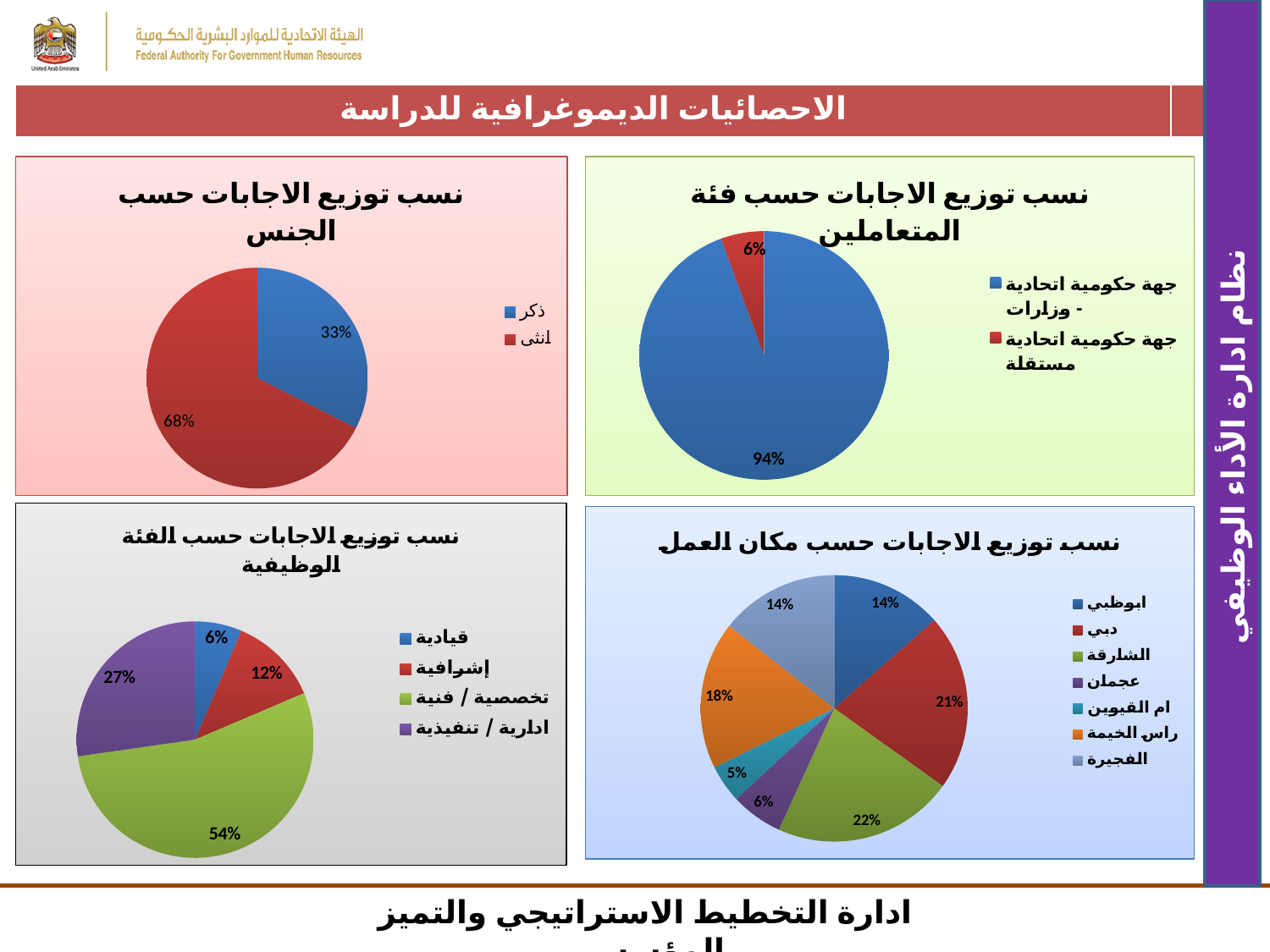
In the bottom-left pie chart (distribution of responses by job category), which category has the largest share? تخصصية / فنية In the bottom-left pie chart (distribution of responses by job category), which category has the smallest share? قيادية In the top-right pie chart (distribution of responses by customer category), how many slices does the pie have? 2 In the top-right pie chart (distribution of responses by customer category), what share is labelled for the federal government entities - ministries (جهة حكومية اتحادية - وزارات) slice? 94% In the bottom-right pie chart (distribution of responses by workplace), which is larger, the share for دبي or the share for ابوظبي? دبي In the bottom-right pie chart (distribution of responses by workplace), how many entries does the legend list? 7 In the top-left pie chart (distribution of responses by gender), what share is labelled for the male (ذكر) slice? 33% In the top-left pie chart (distribution of responses by gender), what share is labelled for the female (أنثى) slice? 68% What type of chart is used in the bottom-left panel (distribution of responses by job category)? Pie chart In the bottom-right pie chart (distribution of responses by workplace), what share is labelled for راس الخيمة? 18% In the bottom-right pie chart (distribution of responses by workplace), which emirate has the smallest share? ام القيوين In the bottom-left pie chart (distribution of responses by job category), what is the difference in percentage points between the ادارية / تنفيذية slice and the إشرافية slice? 15